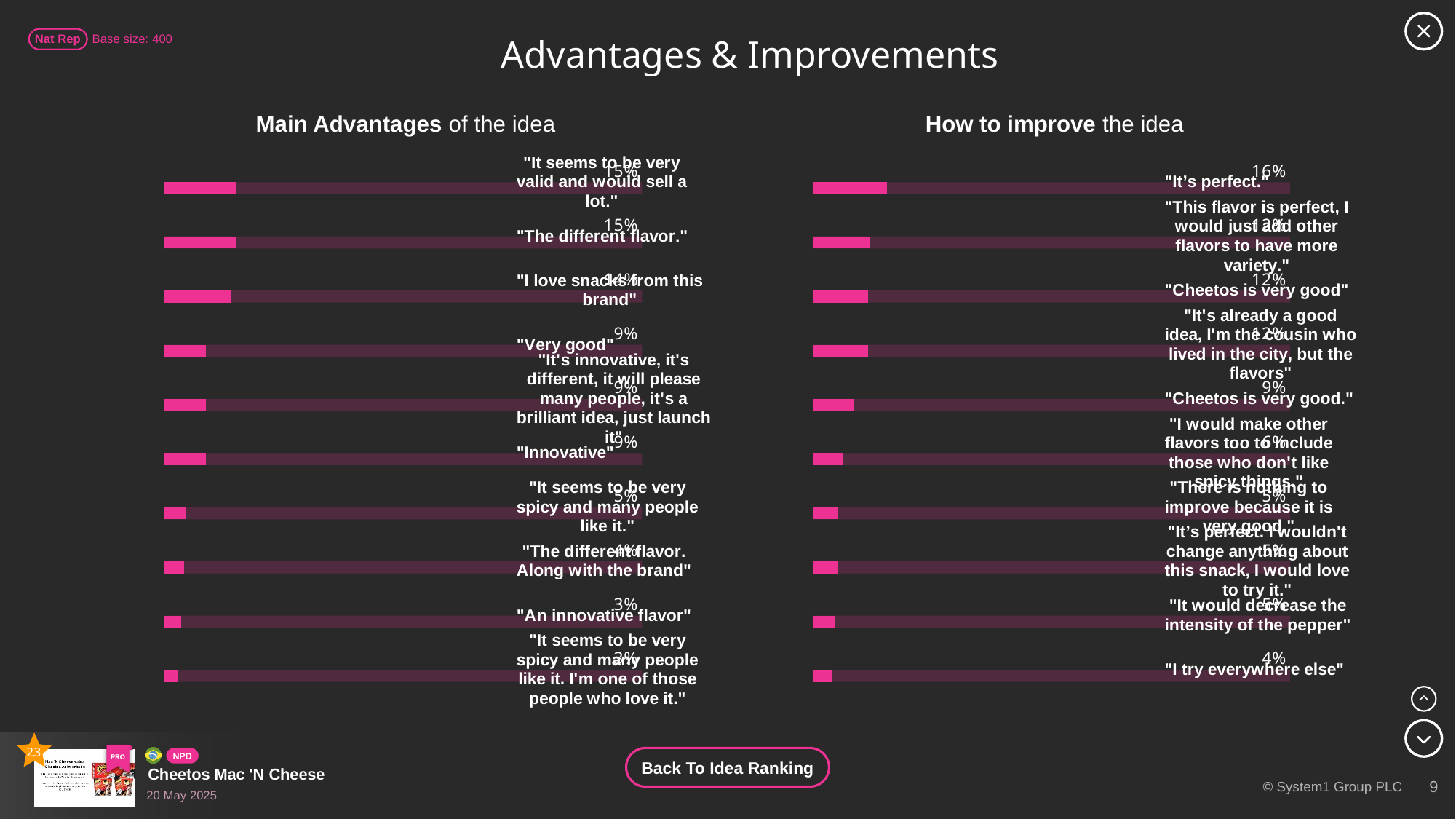
On the 'Main Advantages of the idea' chart, what is the difference between "The different flavor." and "An innovative flavor"? 12 percentage points How many bars are shown on the 'How to improve the idea' chart? 10 On the 'Main Advantages of the idea' chart, what is the value for "The different flavor."? 15% On the 'How to improve the idea' chart, which response has the highest value? "It's perfect." How many bars are shown on the 'Main Advantages of the idea' chart? 10 On the 'Main Advantages of the idea' chart, what is the value for "An innovative flavor"? 3% On the 'Main Advantages of the idea' chart, what is the value for "Very good"? 9% On the 'Main Advantages of the idea' chart, which is larger: "I love snacks from this brand" or "Very good"? "I love snacks from this brand" On the 'How to improve the idea' chart, what is the value for "I try everywhere else"? 4% What type of chart is used on the 'Main Advantages of the idea' chart? Bar chart On the 'How to improve the idea' chart, what is the value for "It's perfect."? 16% On the 'How to improve the idea' chart, which response has the lowest value? "I try everywhere else"